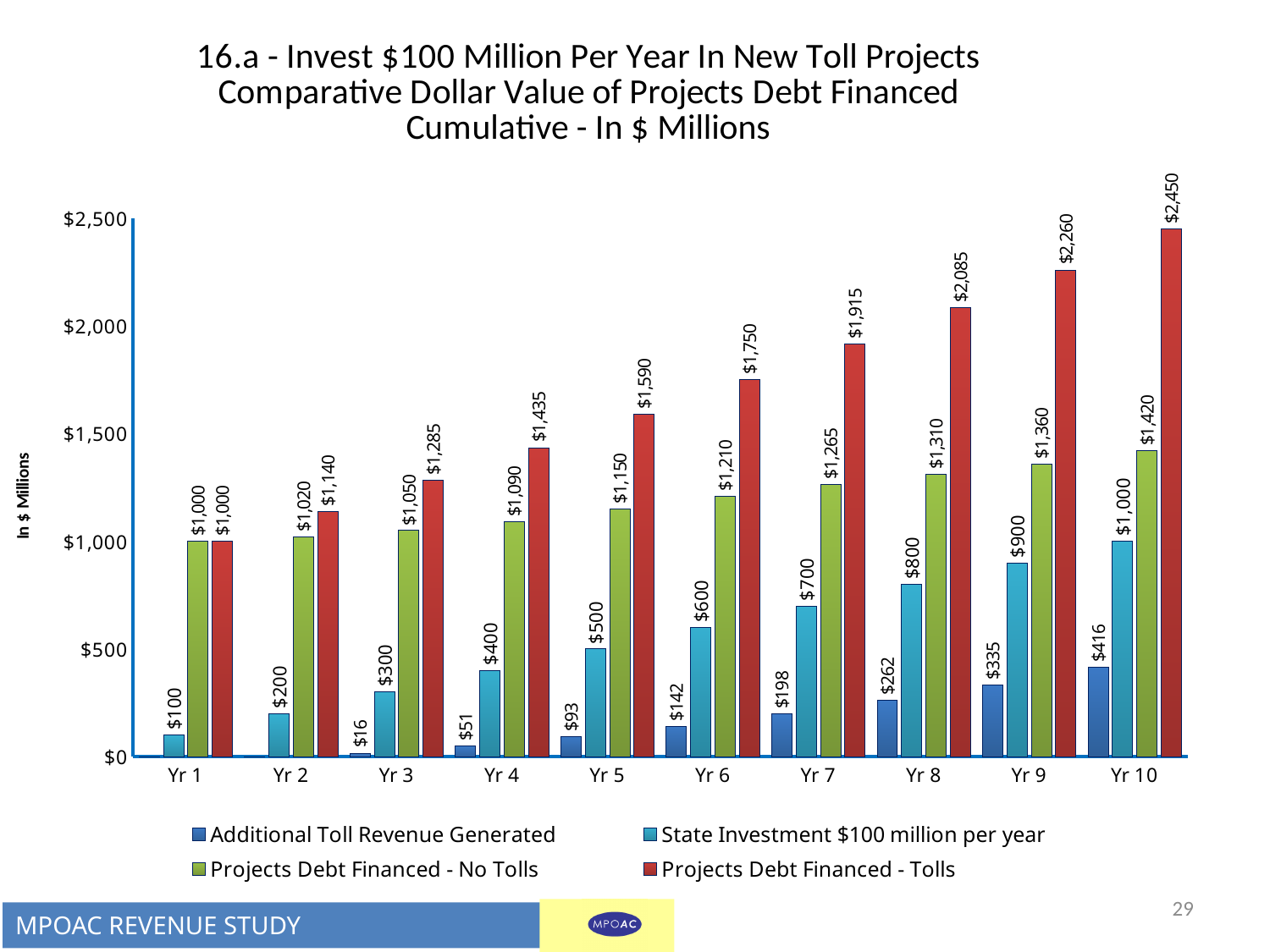
In which year is Projects Debt Financed - Tolls highest? Yr 10 What is the value of State Investment $100 million per year in Yr 8? $800 What is the difference between Projects Debt Financed - Tolls and Projects Debt Financed - No Tolls in Yr 10? $1,030 Which is larger in Yr 6: Projects Debt Financed - Tolls or Projects Debt Financed - No Tolls? Projects Debt Financed - Tolls What is the value of Projects Debt Financed - Tolls in Yr 10? $2,450 What is the value of Projects Debt Financed - No Tolls in Yr 7? $1,265 What is the value of Additional Toll Revenue Generated in Yr 5? $93 What kind of chart is shown on the slide? Bar chart Does Projects Debt Financed - Tolls rise or fall from Yr 1 to Yr 10? Rise How many series does the legend list? 4 How many years are shown on the x axis? 10